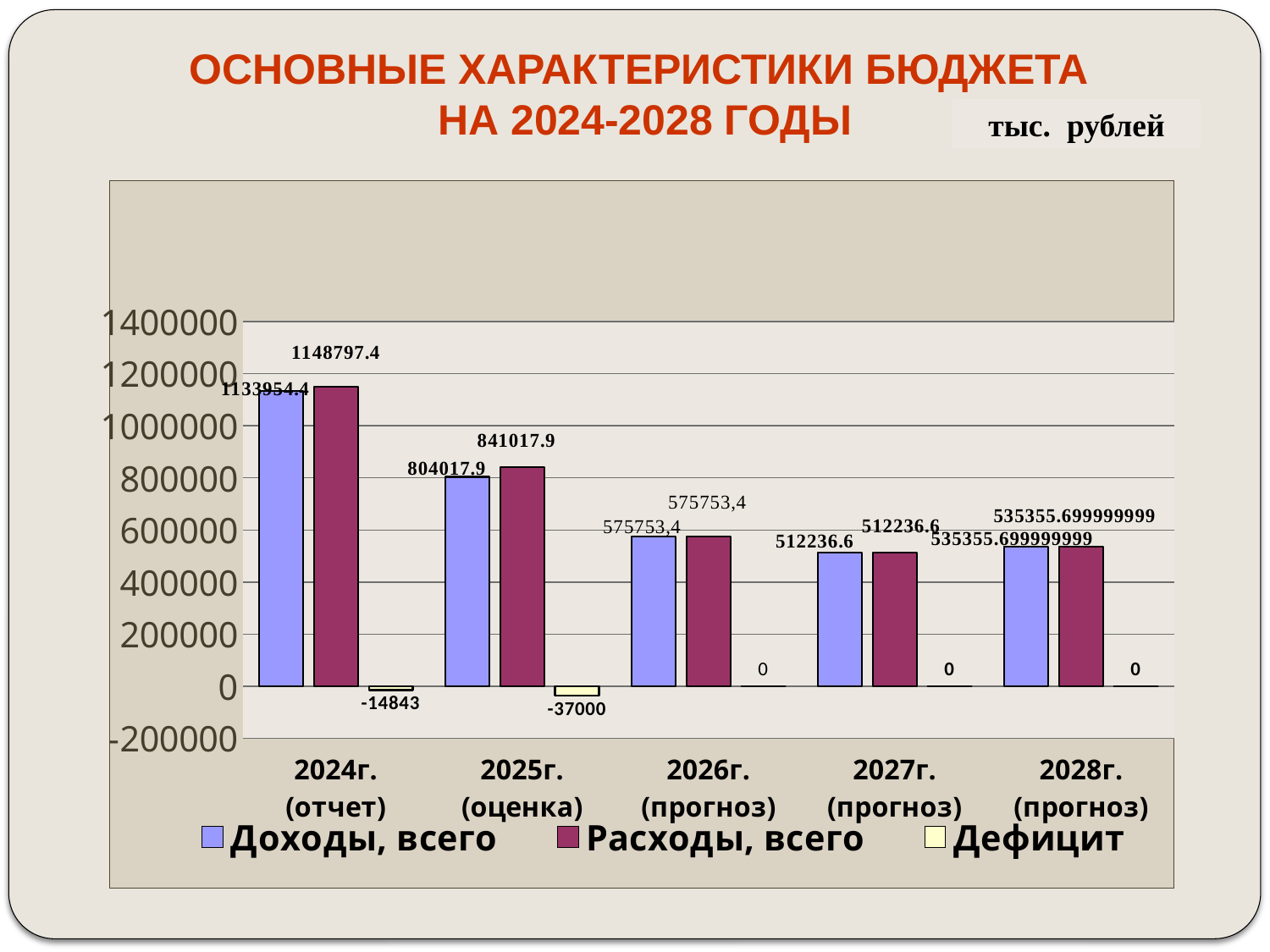
How many series does the legend list? 3 What is the difference between Расходы, всего and Доходы, всего for 2025г. (оценка)? 37000 What is the value of Доходы, всего for 2024г. (отчет)? 1133954.4 What kind of chart is shown on the slide? Bar chart What is the value of Расходы, всего for 2024г. (отчет)? 1148797.4 Which is larger for 2024г. (отчет): Доходы, всего or Расходы, всего? Расходы, всего Which year has the lowest value of Доходы, всего? 2027г. (прогноз) How many year categories are shown on the x axis? 5 What is the value of Дефицит for 2024г. (отчет)? -14843 Which year has the highest value of Расходы, всего? 2024г. (отчет) What is the value of Расходы, всего for 2025г. (оценка)? 841017.9 What is the value of Дефицит for 2025г. (оценка)? -37000